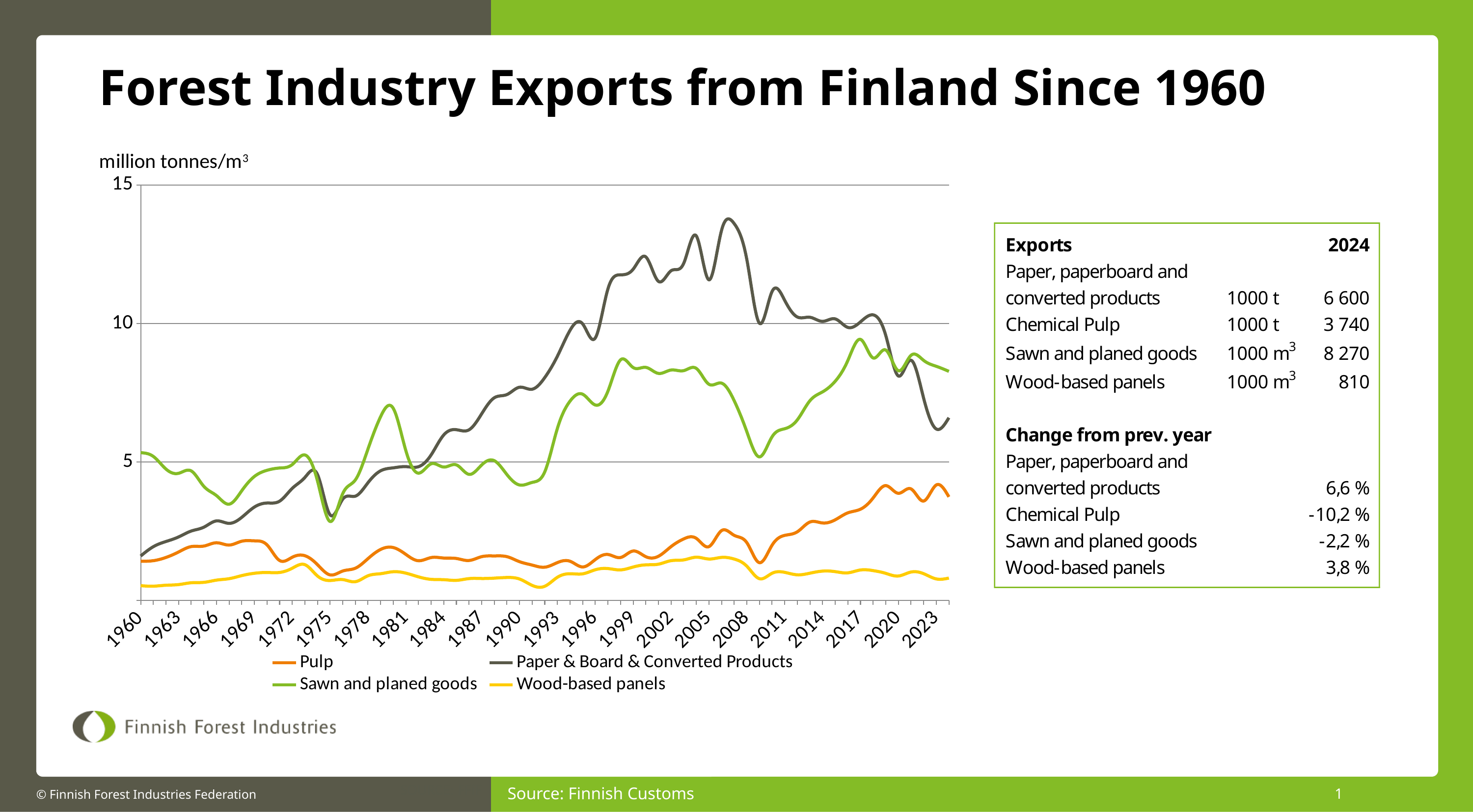
Does the Paper & Board & Converted Products line rise or fall from 2008 to 2023? fall How many series does the chart legend list? 4 What unit is shown above the y axis of the chart? million tonnes/m³ What kind of chart is shown on the slide? line chart Is the value for Paper & Board & Converted Products in 2008 greater or less than 10? greater Which is larger in 1960, Sawn and planed goods or Paper & Board & Converted Products? Sawn and planed goods Which is larger in 2005, Paper & Board & Converted Products or Sawn and planed goods? Paper & Board & Converted Products Is the value for Pulp in 2023 greater or less than 5? less Which series has the lowest value in 2023? Wood-based panels Does the Paper & Board & Converted Products line rise or fall from 1960 to 2008? rise Is the value for Paper & Board & Converted Products in 1960 greater or less than 5? less Which series has the highest value in 2008? Paper & Board & Converted Products